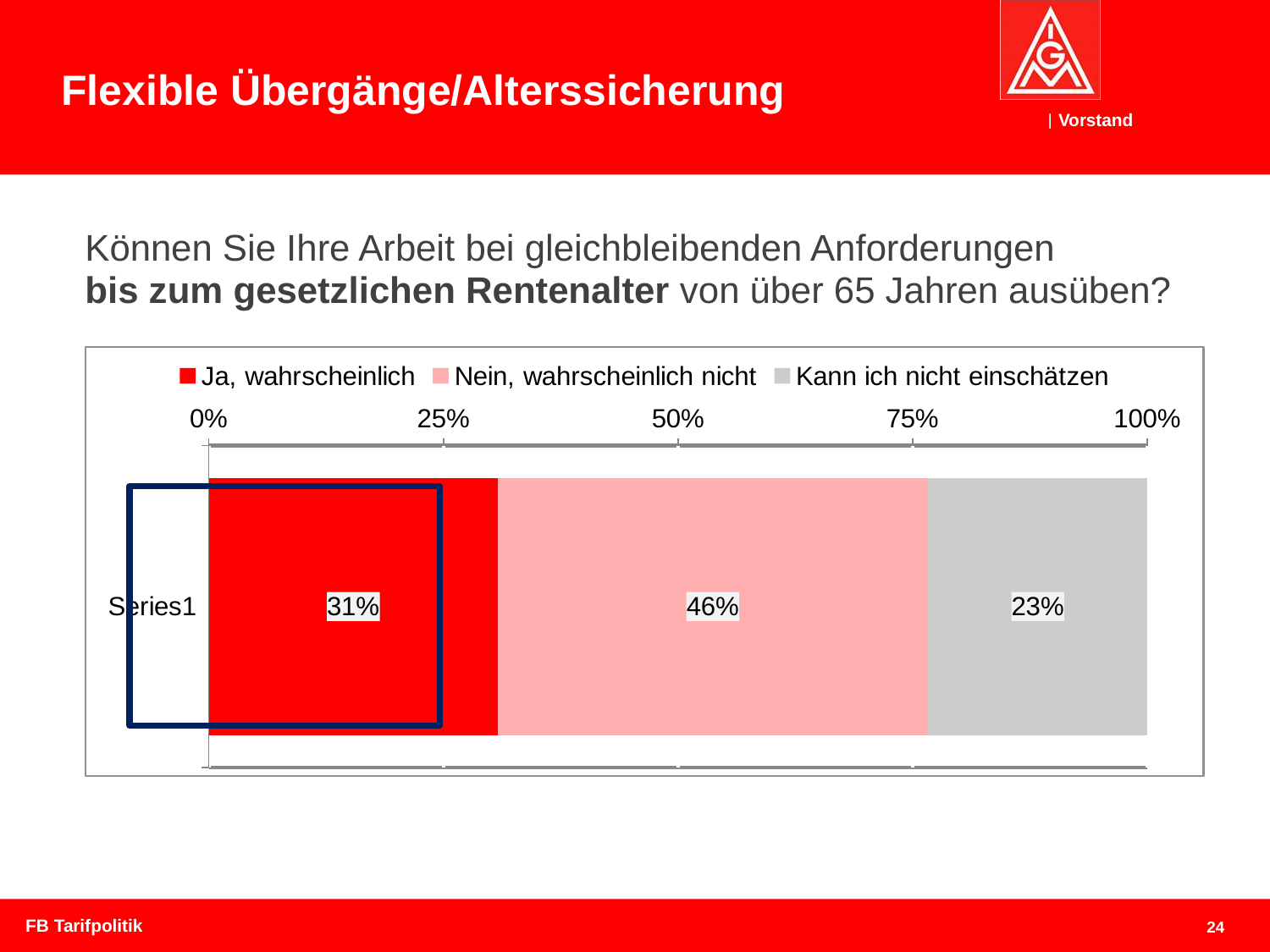
What kind of chart is shown on the slide? Stacked bar chart Which response has the largest share? Nein, wahrscheinlich nicht What percentage of respondents answered "Nein, wahrscheinlich nicht"? 46% What is the total of the three segments in the stacked bar? 100% Which is larger: the share for "Ja, wahrscheinlich" or for "Kann ich nicht einschätzen"? Ja, wahrscheinlich Which response has the smallest share? Kann ich nicht einschätzen Is the value for "Nein, wahrscheinlich nicht" greater or less than 25%? greater How many series does the legend list? 3 What is the difference in percentage points between "Nein, wahrscheinlich nicht" and "Ja, wahrscheinlich"? 15 percentage points What percentage of respondents answered "Kann ich nicht einschätzen"? 23% What percentage of respondents answered "Ja, wahrscheinlich"? 31% What colour is the "Kann ich nicht einschätzen" segment? Grey